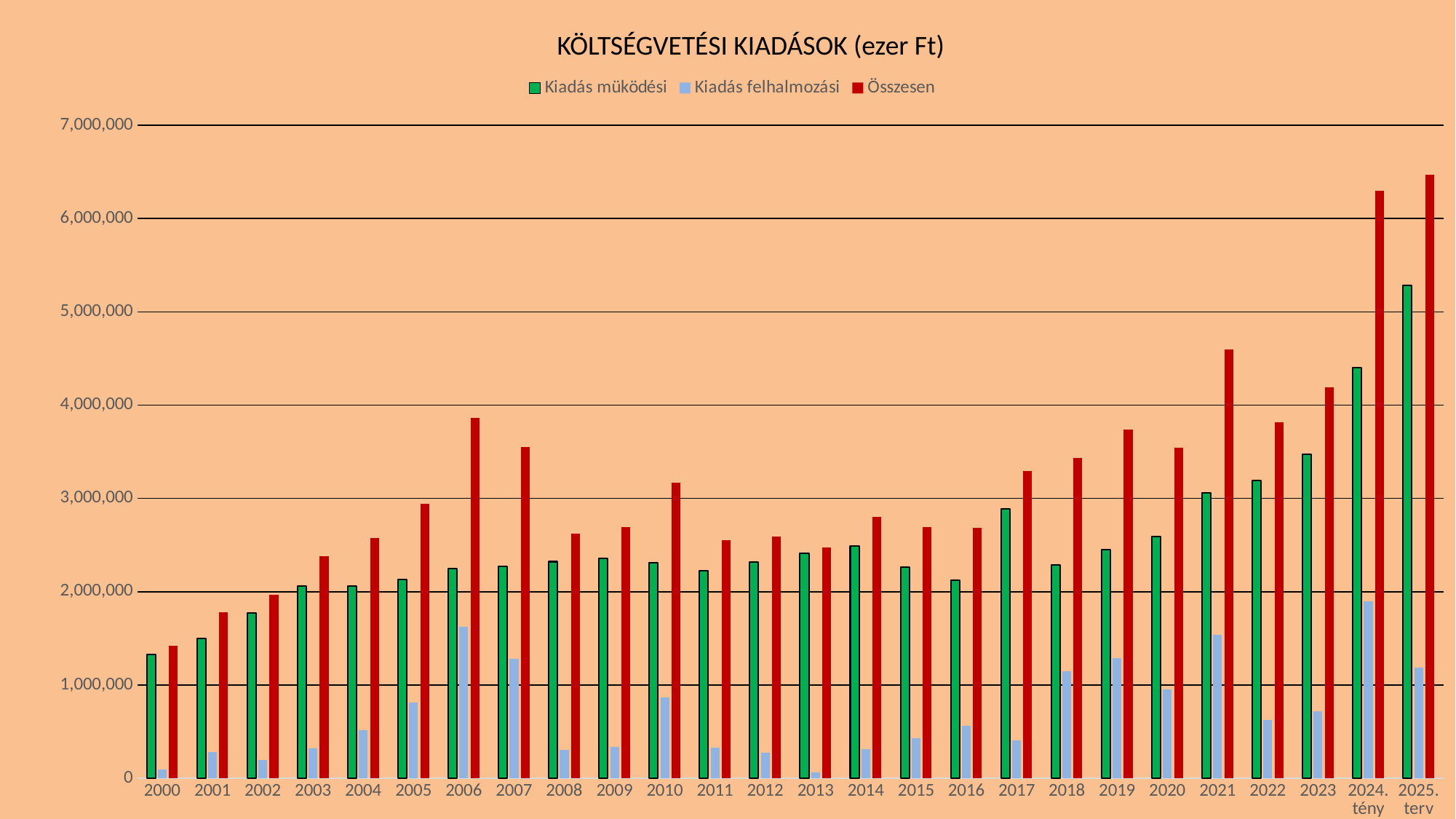
Which category has the highest value for Összesen? 2025. terv Does the Összesen series rise or fall from 2017 to 2025. terv? rise What is the title of the chart? KÖLTSÉGVETÉSI KIADÁSOK (ezer Ft) How many series does the legend list? 3 Which category has the highest value for Kiadás felhalmozási? 2024. tény Which is larger, the Összesen value for 2006 or for 2007? 2006 Is the value for Kiadás felhalmozási in 2016 greater or less than 1,000,000? less Which category has the lowest value for Összesen? 2000 What kind of chart is shown on the slide? bar chart Is the value for Összesen in 2021 greater or less than 4,000,000? greater Is the value for Összesen in 2006 greater or less than 3,000,000? greater How many categories are shown on the x axis? 26